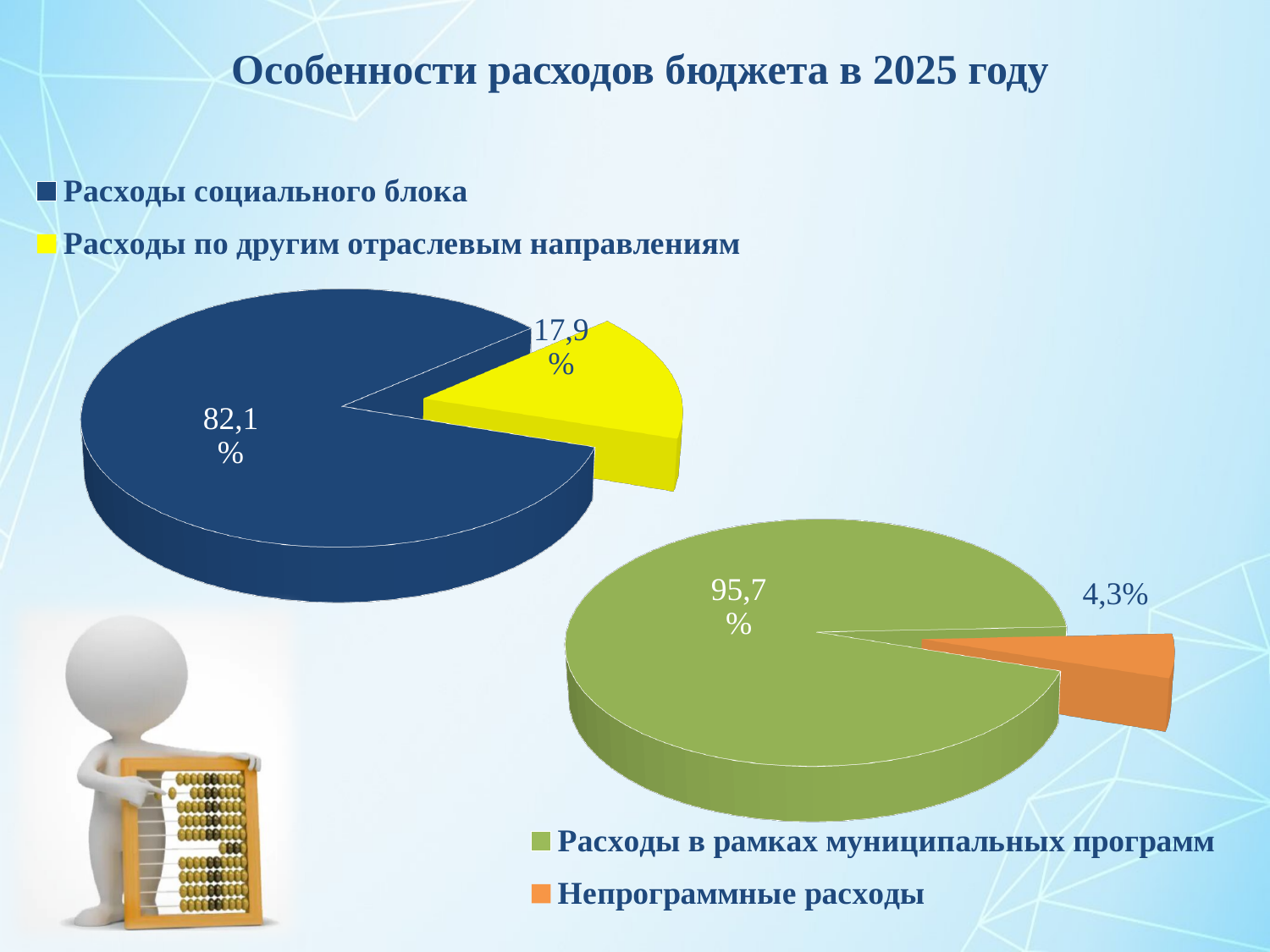
In the lower-right pie chart, what share is shown for Непрограммные расходы? 4,3% How many slices does the upper-left pie chart have? 2 In the lower-right pie chart, what is the difference in percentage points between Расходы в рамках муниципальных программ and Непрограммные расходы? 91,4 In the lower-right pie chart, which category has the smallest slice? Непрограммные расходы In the lower-right pie chart, what colour is the slice for Непрограммные расходы? Orange What type of chart is the lower-right chart? Pie chart In the upper-left pie chart, what share is shown for Расходы по другим отраслевым направлениям? 17,9% Which is larger: the share of Непрограммные расходы in the lower-right chart or the share of Расходы по другим отраслевым направлениям in the upper-left chart? Расходы по другим отраслевым направлениям In the lower-right pie chart, what share is shown for Расходы в рамках муниципальных программ? 95,7% In the upper-left pie chart, what is the difference in percentage points between Расходы социального блока and Расходы по другим отраслевым направлениям? 64,2 In the upper-left pie chart, which category has the largest slice? Расходы социального блока In the upper-left pie chart, what share is shown for Расходы социального блока? 82,1%